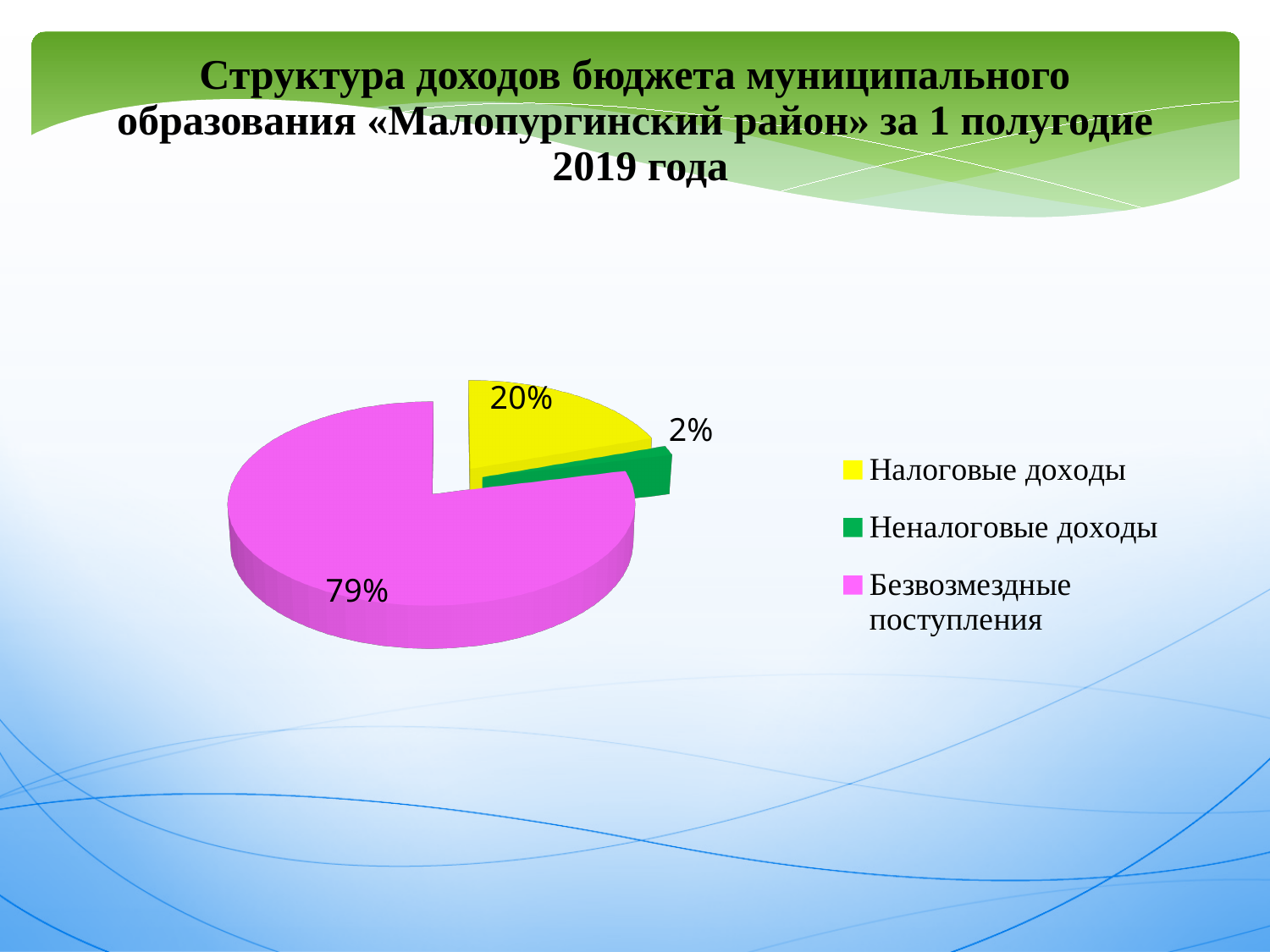
What is the difference in percentage points between Безвозмездные поступления and Налоговые доходы? 59 What kind of chart is shown on the slide? Pie chart What share of the pie does Неналоговые доходы represent? 2% Which category has the largest slice of the pie? Безвозмездные поступления Which category has the smallest slice of the pie? Неналоговые доходы What is the difference in percentage points between Налоговые доходы and Неналоговые доходы? 18 What colour is the slice for Безвозмездные поступления? Pink How many categories are shown in the pie chart? 3 What share of the pie does Безвозмездные поступления represent? 79% Which is larger, the share for Налоговые доходы or the share for Неналоговые доходы? Налоговые доходы What share of the pie does Налоговые доходы represent? 20% What colour is the slice for Налоговые доходы? Yellow